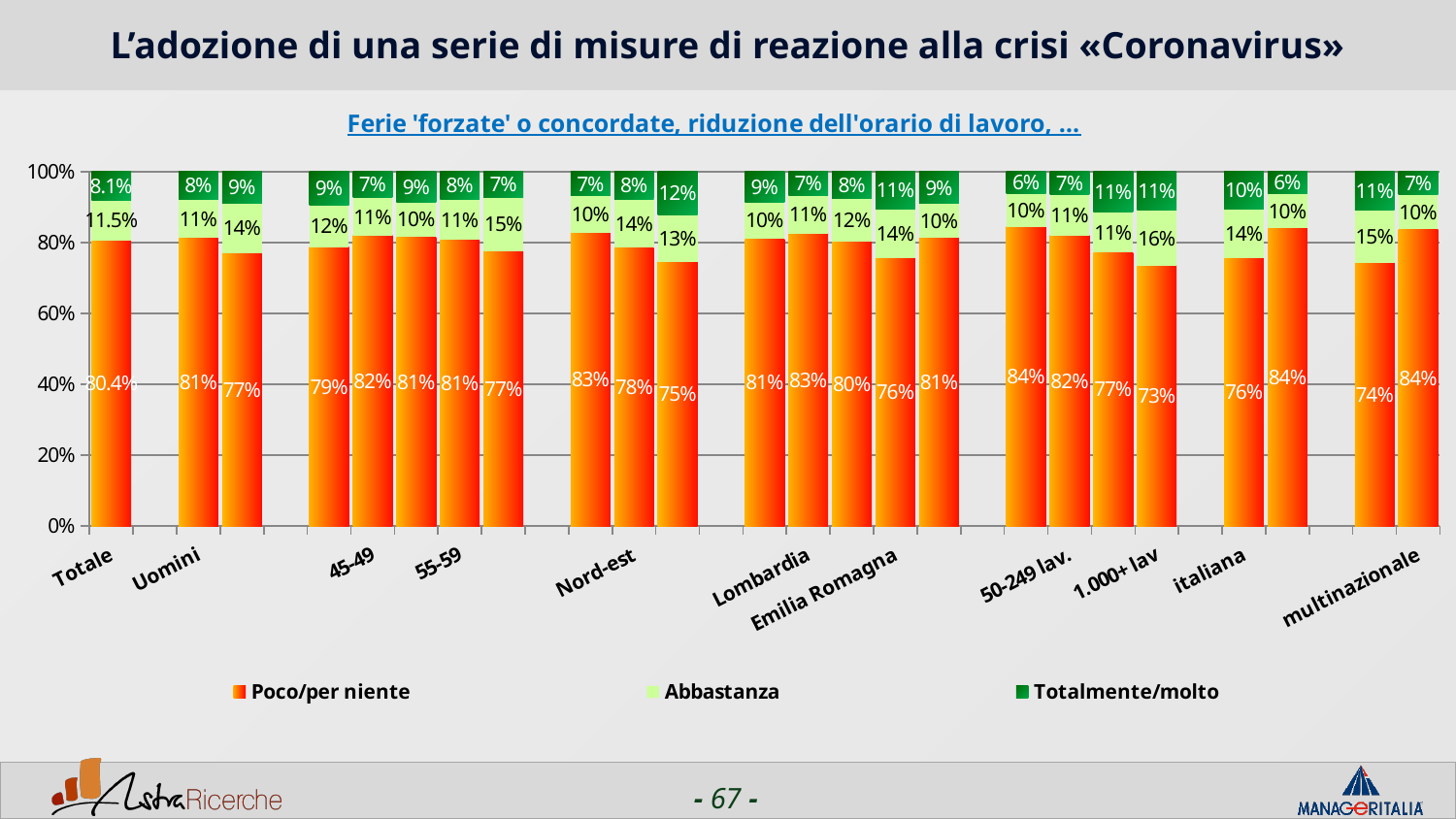
What kind of chart is shown on the slide? Stacked bar chart What is the 'Abbastanza' value for 1.000+ lav? 16% What is the 'Poco/per niente' value for multinazionale? 84% Which has a larger 'Poco/per niente' value, 50-249 lav. or 1.000+ lav? 50-249 lav. What is the value of the 'Totalmente/molto' series for Totale? 8.1% Which category has the lowest 'Poco/per niente' value? 1.000+ lav What is the difference in the 'Poco/per niente' value between Lombardia and Emilia Romagna? 7 percentage points What is the value of the 'Poco/per niente' series for Totale? 80.4% What is the value of the 'Abbastanza' series for Totale? 11.5% What is the 'Poco/per niente' value for Lombardia? 83% How many series does the legend list? 3 What is the 'Totalmente/molto' value for Emilia Romagna? 11%